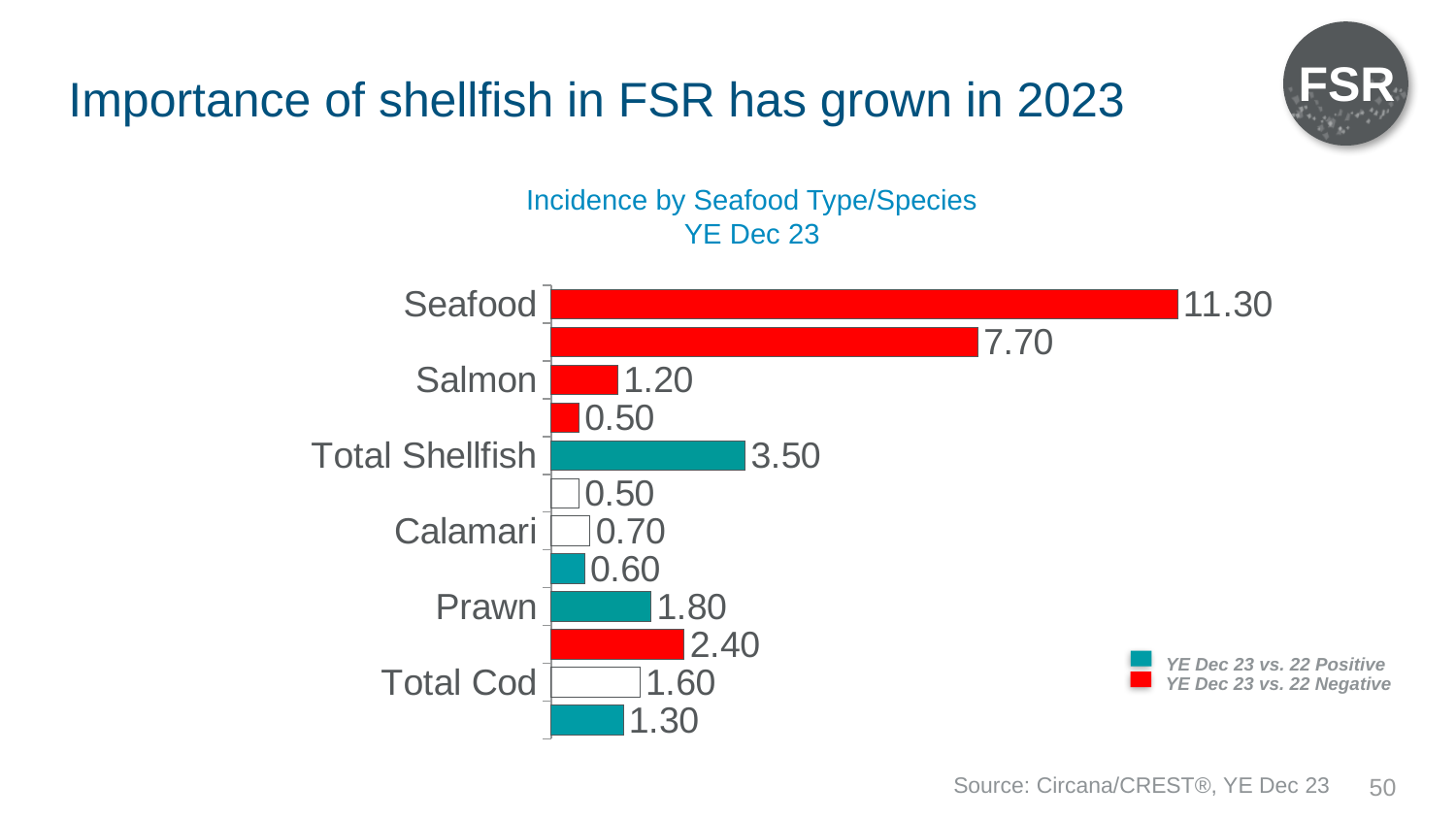
What is the difference between the values for Seafood and Total Shellfish? 7.80 What is the value shown for Prawn? 1.80 Which labelled category has the highest value? Seafood How many entries does the legend list? 2 What is the difference between the values for Total Shellfish and Prawn? 1.70 What kind of chart is shown on the slide? Bar chart What is the value shown for Total Cod? 1.60 What is the value shown for Calamari? 0.70 What is the value shown for Total Shellfish? 3.50 What is the value shown for Salmon? 1.20 Which has the larger value, Salmon or Prawn? Prawn What is the value shown for Seafood? 11.30